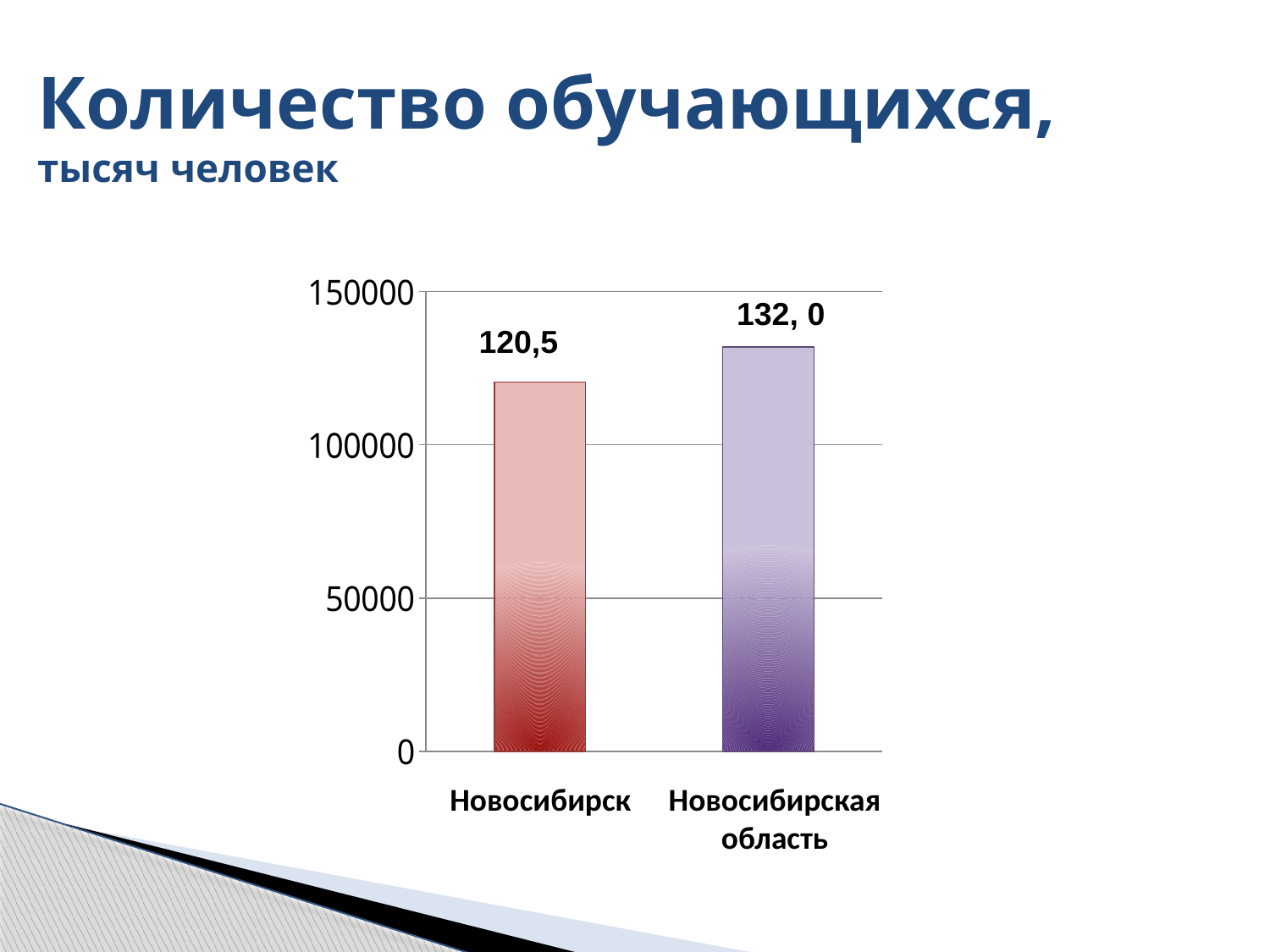
Is the value for Новосибирск larger or smaller than the value for Новосибирская область? smaller What is the value shown for Новосибирская область? 132, 0 Which category has the higher value? Новосибирская область Which category has the lower value? Новосибирск What is the title of the slide? Количество обучающихся, тысяч человек What is the highest value labelled on the vertical axis? 150000 Is the bar for Новосибирская область greater or less than 150000 on the axis? less How many categories are shown in the chart? 2 What is the value shown for Новосибирск? 120,5 Is the bar for Новосибирск greater or less than 100000 on the axis? greater What is the difference between the values for Новосибирская область and Новосибирск? 11,5 What kind of chart is shown on the slide? bar chart